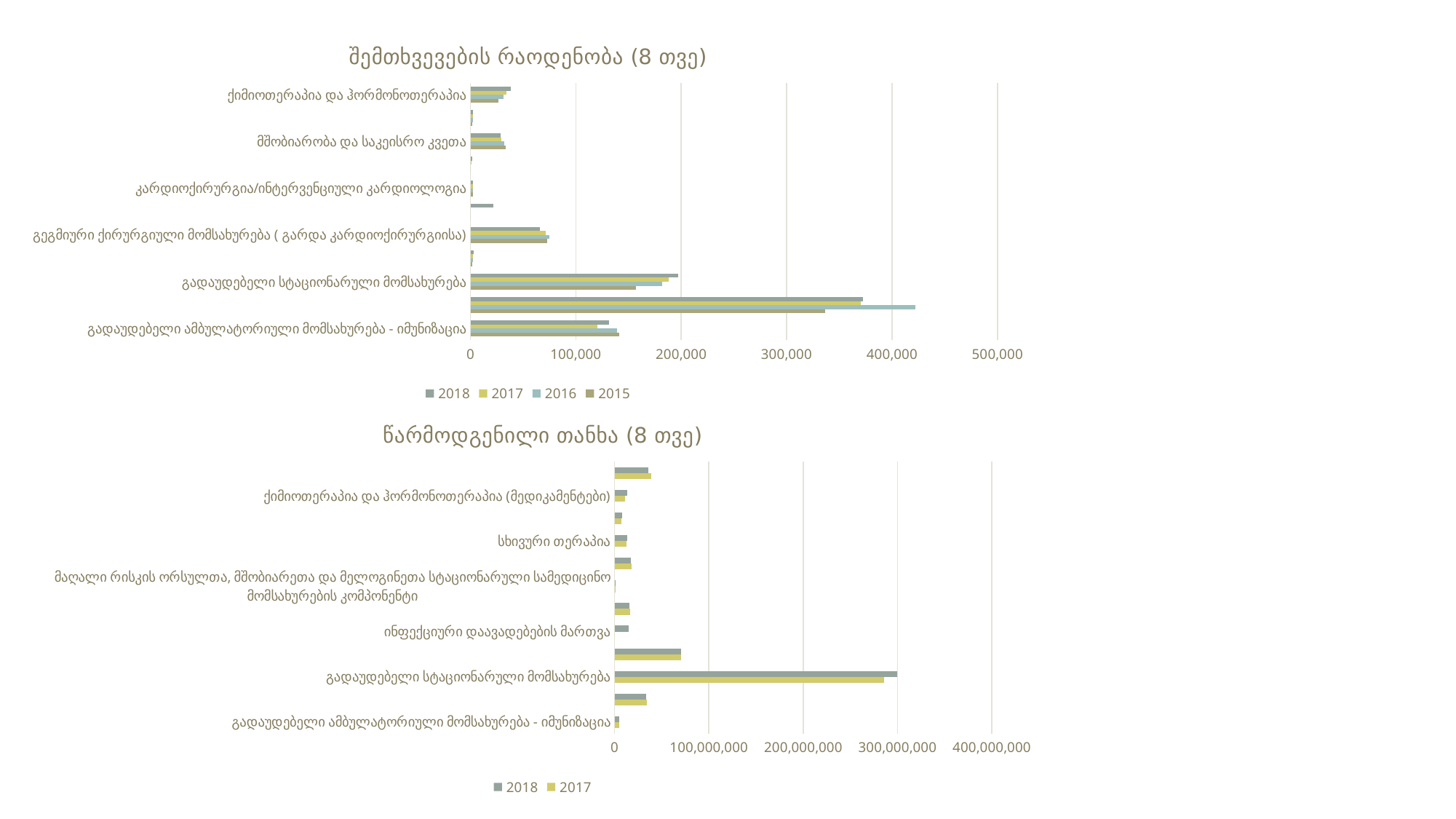
What kind of chart is the bottom chart titled "წარმოდგენილი თანხა (8 თვე)"? bar chart How many series does the legend of the bottom chart "წარმოდგენილი თანხა (8 თვე)" list? 2 What is the title of the bottom chart on the slide? წარმოდგენილი თანხა (8 თვე) In the top chart "შემთხვევების რაოდენობა (8 თვე)", is the 2018 value for გადაუდებელი სტაციონარული მომსახურება greater or less than 100,000? greater Which series are listed in the legend of the top chart "შემთხვევების რაოდენობა (8 თვე)"? 2018, 2017, 2016, 2015 In the bottom chart "წარმოდგენილი თანხა (8 თვე)", is the 2018 value for გადაუდებელი ამბულატორიული მომსახურება - იმუნიზაცია greater or less than 100,000,000? less What kind of chart is the top chart titled "შემთხვევების რაოდენობა (8 თვე)"? bar chart In the bottom chart "წარმოდგენილი თანხა (8 თვე)", is the 2018 value for გადაუდებელი სტაციონარული მომსახურება greater or less than 200,000,000? greater How many series does the legend of the top chart "შემთხვევების რაოდენობა (8 თვე)" list? 4 In the bottom chart "წარმოდგენილი თანხა (8 თვე)", which series has the larger value for გადაუდებელი სტაციონარული მომსახურება, 2018 or 2017? 2018